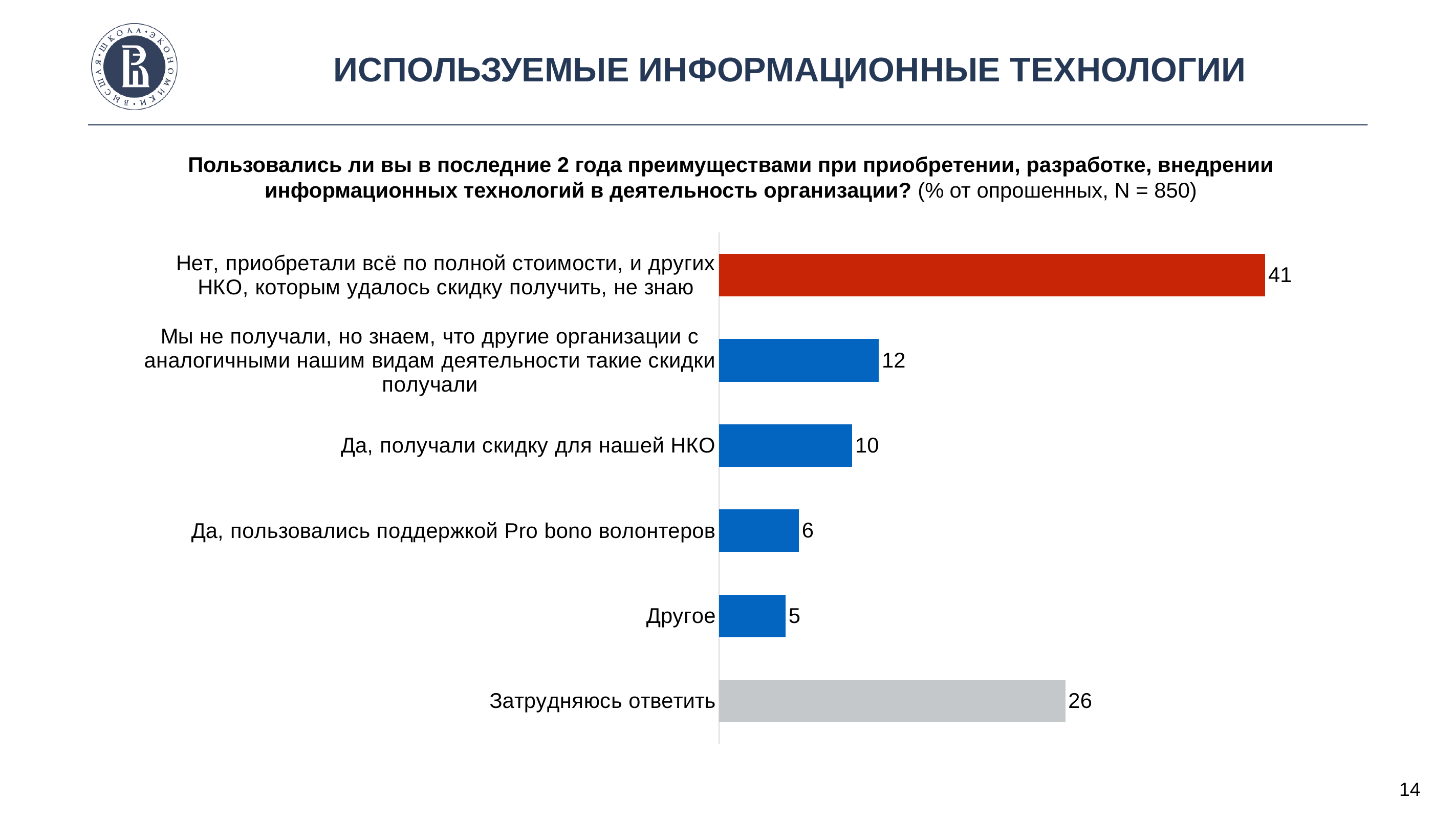
What colour is the bar for "Затрудняюсь ответить"? Grey Which category has the lowest value? Другое What is the value for "Другое"? 5 What is the difference between the value for "Нет, приобретали всё по полной стоимости, и других НКО, которым удалось скидку получить, не знаю" and the value for "Затрудняюсь ответить"? 15 Which category has the highest value? Нет, приобретали всё по полной стоимости, и других НКО, которым удалось скидку получить, не знаю What is the value for "Да, получали скидку для нашей НКО"? 10 What kind of chart is shown on the slide? Bar chart What is the value for "Да, пользовались поддержкой Pro bono волонтеров"? 6 What is the value for "Затрудняюсь ответить"? 26 Which is larger: the value for "Да, пользовались поддержкой Pro bono волонтеров" or the value for "Другое"? Да, пользовались поддержкой Pro bono волонтеров How many categories are shown in the chart? 6 What is the difference between the value for "Мы не получали, но знаем, что другие организации с аналогичными нашим видам деятельности такие скидки получали" and the value for "Да, получали скидку для нашей НКО"? 2